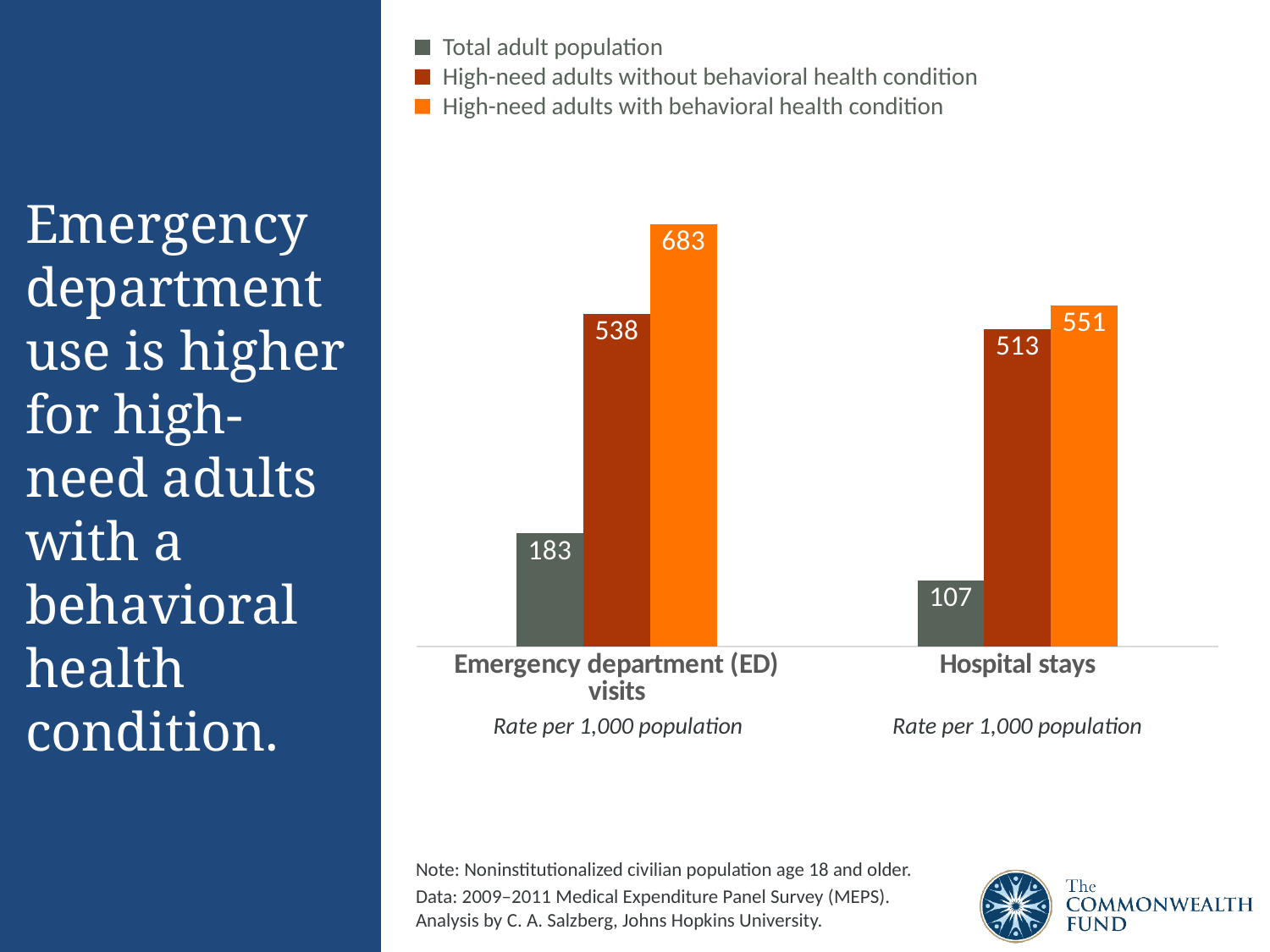
What kind of chart is shown on the slide? Bar chart What is the emergency department (ED) visit rate per 1,000 population for high-need adults with a behavioral health condition? 683 What is the hospital stay rate for high-need adults with a behavioral health condition? 551 How many series does the legend list? 3 What is the difference between the ED visit rates of high-need adults with and without a behavioral health condition? 145 Which group has the lowest hospital stay rate? Total adult population How many categories are shown on the x axis? 2 Which group has the highest emergency department (ED) visit rate? High-need adults with behavioral health condition Which is larger: the ED visit rate for the total adult population or the hospital stay rate for the total adult population? ED visit rate (183) What is the hospital stay rate per 1,000 population for the total adult population? 107 What is the emergency department (ED) visit rate for high-need adults without a behavioral health condition? 538 What is the difference between the hospital stay rate for high-need adults without a behavioral health condition and the total adult population? 406